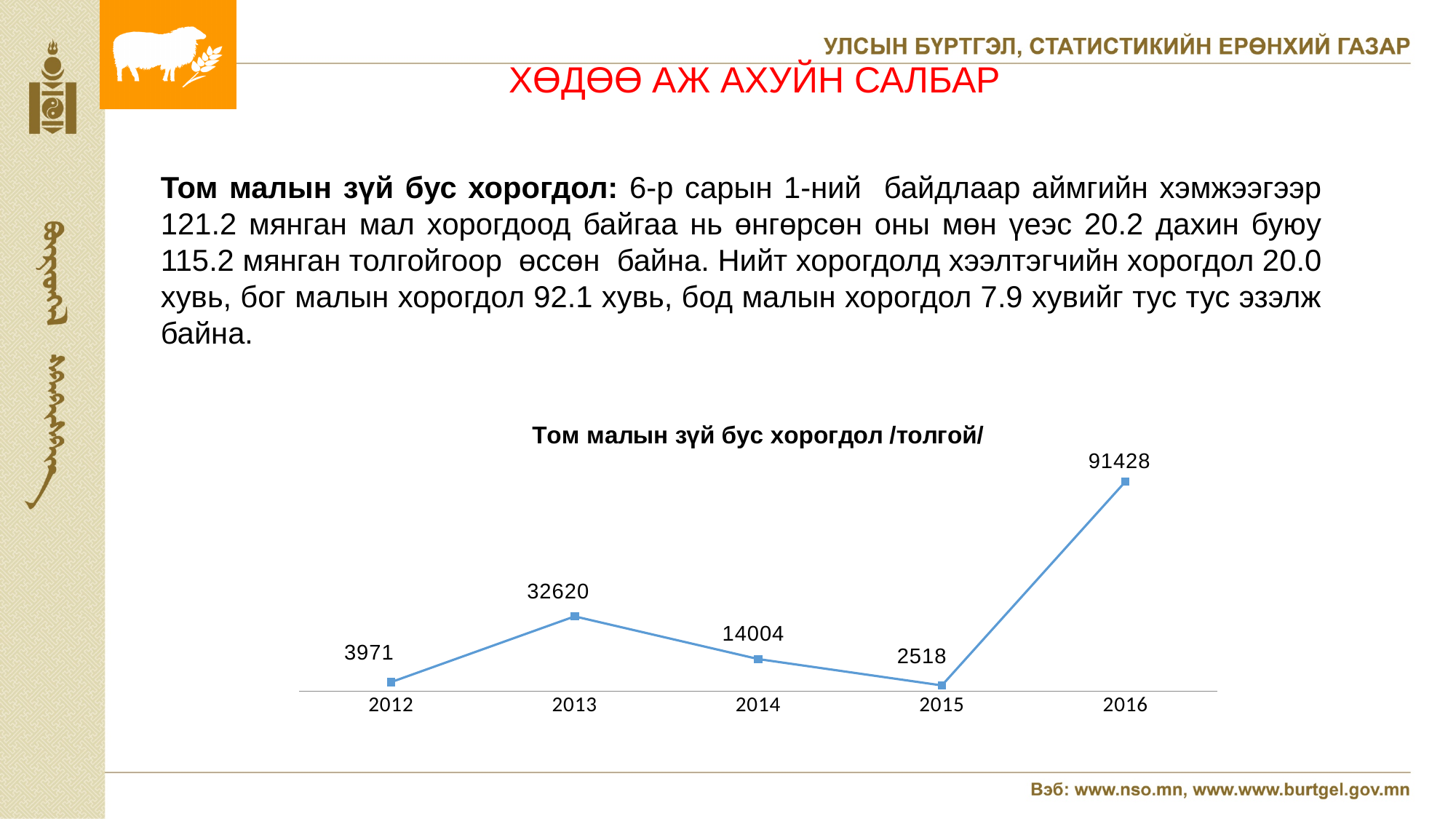
What is the value for 2016? 91428 What is the value for 2013? 32620 How many years are plotted on the chart? 5 What is the value for 2012? 3971 What kind of chart is shown? line chart What is the difference between the values for 2016 and 2015? 88910 Which year has the highest value? 2016 What is the difference between the values for 2013 and 2014? 18616 What is the value for 2015? 2518 What is the title of the chart? Том малын зүй бус хорогдол /толгой/ Which year has the lowest value? 2015 Which is larger, the value for 2014 or the value for 2012? 2014